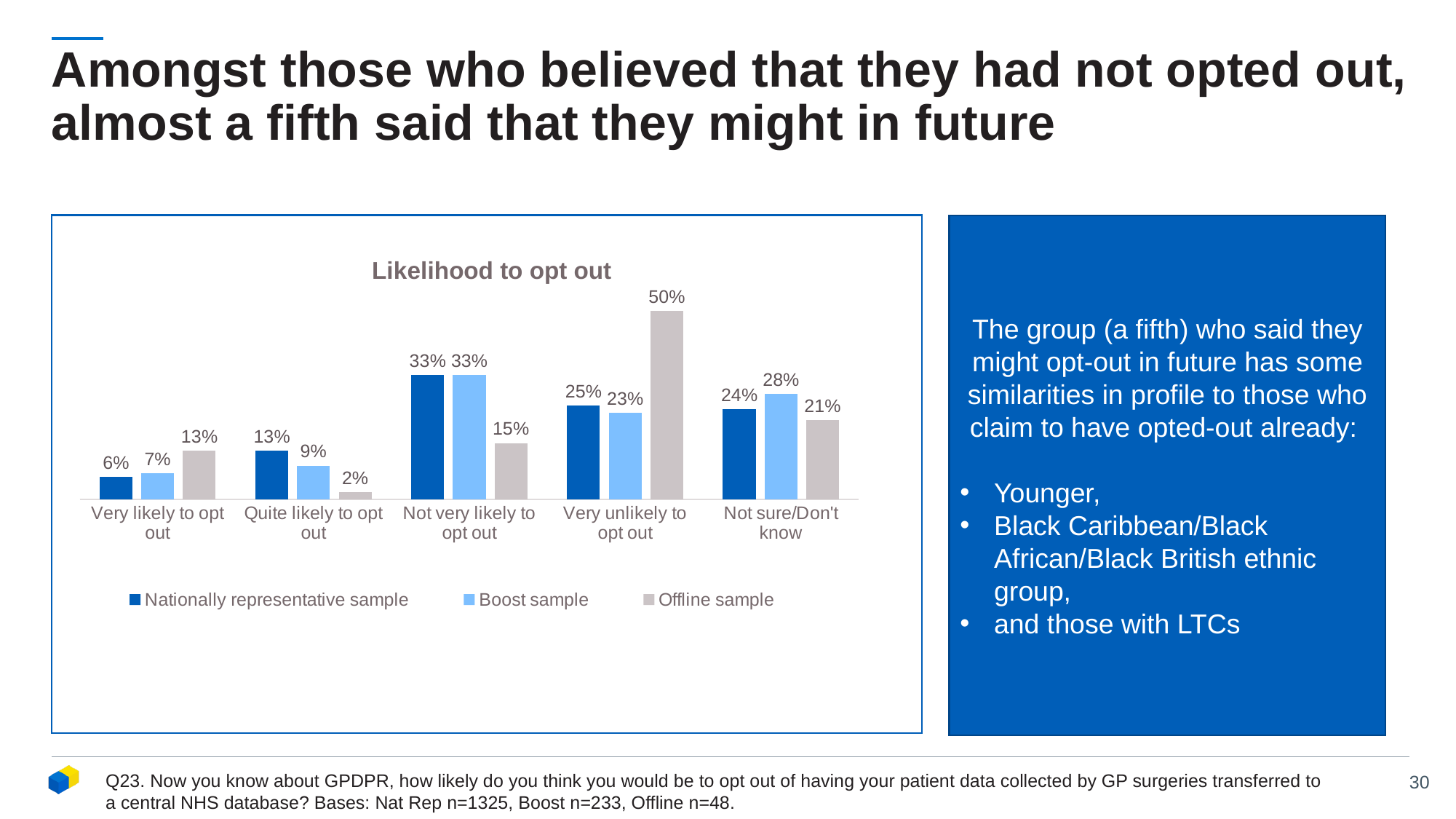
How many categories are shown on the x axis of the chart? 5 Which category has the lowest value for the Nationally representative sample? Very likely to opt out What kind of chart is shown on the slide? Bar chart In the 'Quite likely to opt out' category, which is larger: the Boost sample or the Offline sample? Boost sample Which category has the highest value for the Offline sample? Very unlikely to opt out What is the difference between the Offline sample and the Boost sample in the 'Very unlikely to opt out' category? 27% How many series does the legend list? 3 What is the title of the chart? Likelihood to opt out What is the value for the Offline sample in the 'Very unlikely to opt out' category? 50% What is the value for the Boost sample in the 'Not sure/Don't know' category? 28% Which series is shown in grey in the chart? Offline sample What is the value for the Nationally representative sample in the 'Quite likely to opt out' category? 13%